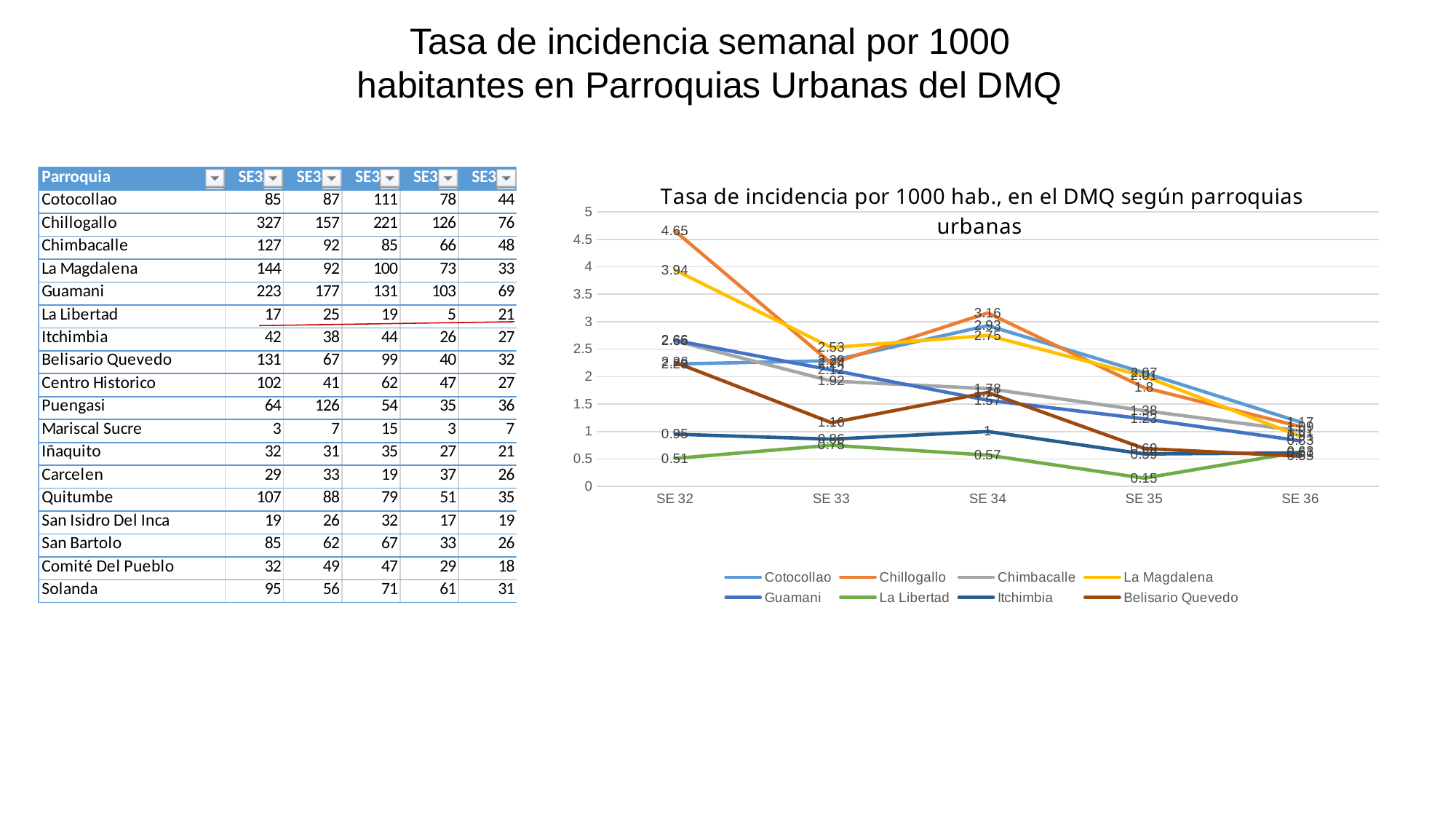
What is the value for Chillogallo at SE 32 in the chart? 4.65 Which parroquia has the highest value at SE 32 in the chart? Chillogallo What kind of chart is shown on the slide? line chart What is the title of the chart on the slide? Tasa de incidencia por 1000 hab., en el DMQ según parroquias urbanas What is the difference between the values of Chillogallo and La Magdalena at SE 32 in the chart? 0.71 How many epidemiological weeks (SE) are plotted along the x axis of the chart? 5 How many series does the legend of the chart list? 8 What is the value for La Magdalena at SE 32 in the chart? 3.94 What is the value for La Libertad at SE 35 in the chart? 0.15 Which parroquia has the lowest value at SE 35 in the chart? La Libertad Does the Chillogallo line rise or fall from SE 34 to SE 36 in the chart? fall Is the value for Chillogallo higher at SE 32 or at SE 34 in the chart? SE 32